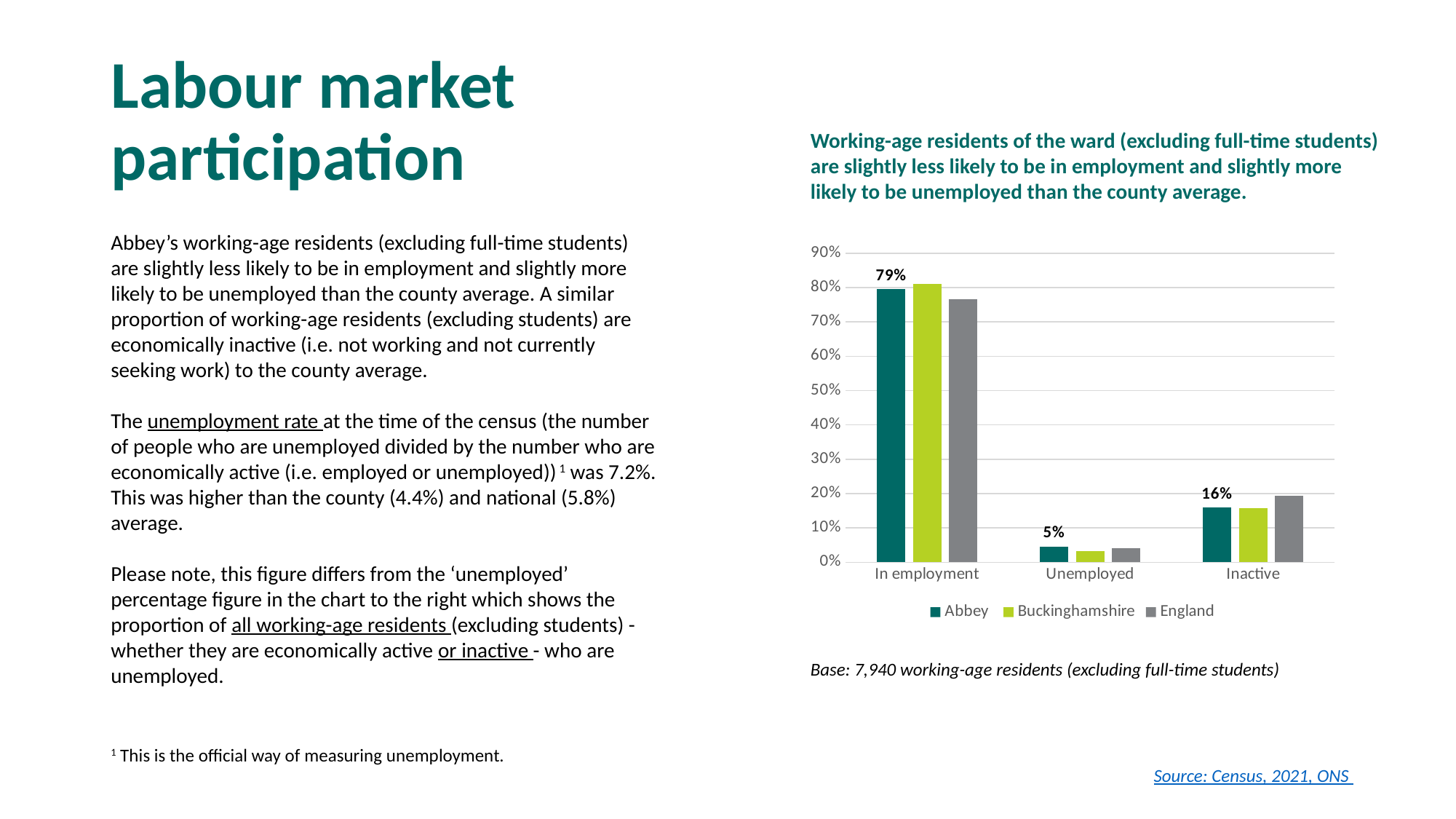
In the Inactive category, which is larger: the Abbey bar or the England bar? England What is the difference between Abbey's In employment value and its Inactive value? 63 percentage points Which category has the lowest value for Abbey? Unemployed How many categories are shown on the x axis of the chart? 3 What is the value for Abbey in the Unemployed category? 5% What kind of chart is shown on the slide? Bar chart What is the value for Abbey in the In employment category? 79% Which category has the highest value for Abbey? In employment Is the value for Buckinghamshire in the In employment category greater or less than 70%? greater What is the value for Abbey in the Inactive category? 16% Is the value for England in the Unemployed category greater or less than 10%? less How many series does the chart's legend list? 3